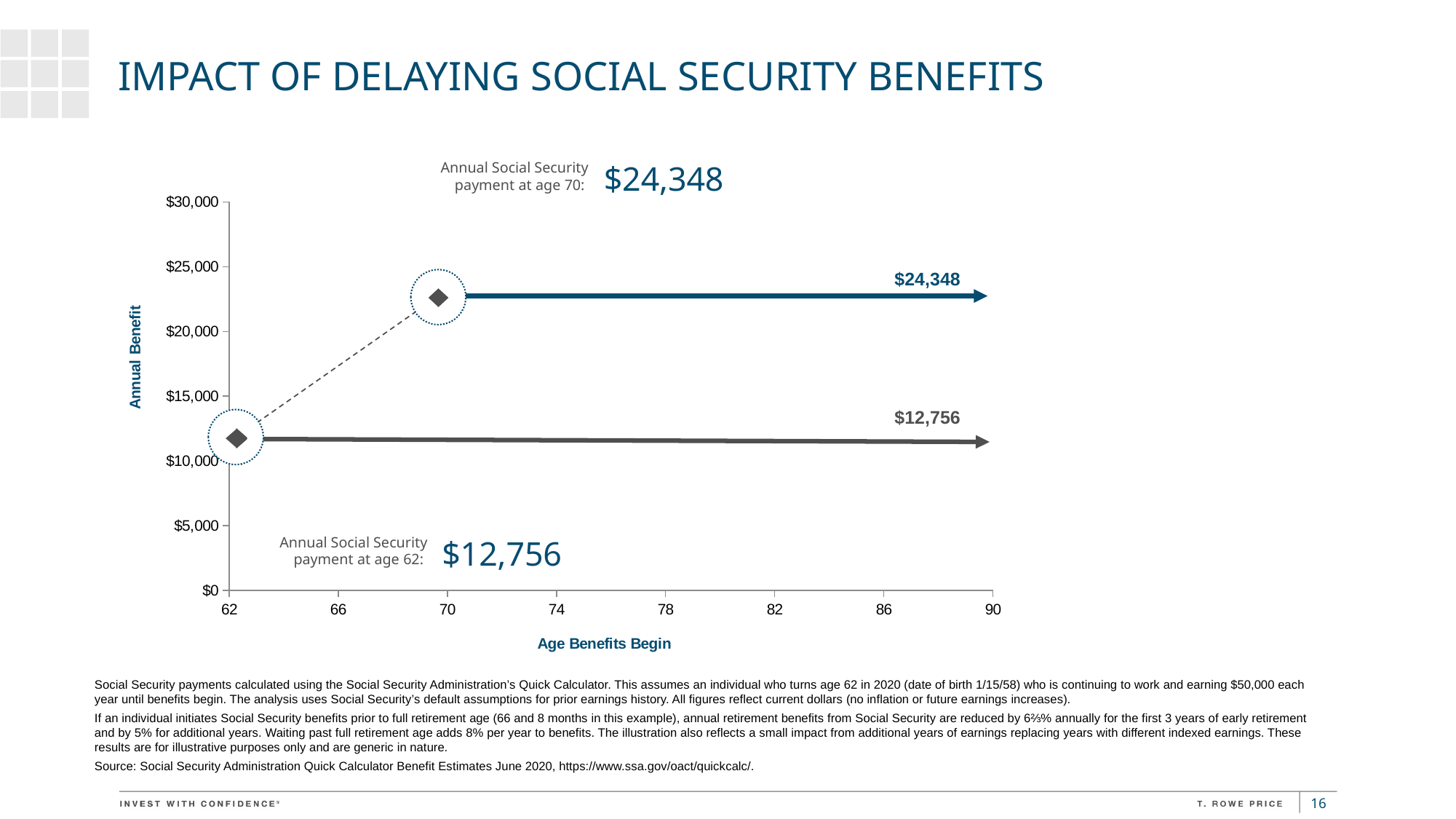
What is the title of the y axis? Annual Benefit Which starting age gives the higher annual benefit, 62 or 70? 70 What is the title of the x axis? Age Benefits Begin How much larger is the annual benefit when starting at age 70 than when starting at age 62? $11,592 Is the annual benefit for starting at age 62 greater or less than $15,000? less What is the annual Social Security payment if benefits begin at age 70? $24,348 Which of the two starting ages shown yields the lowest annual benefit? 62 What is the annual Social Security payment if benefits begin at age 62? $12,756 How many benefit-start scenarios (lines) are plotted on the chart? 2 Does the annual benefit for each scenario rise, fall, or stay flat as age increases along the x axis? stays flat What kind of chart is shown on the slide? line chart Is the annual benefit for starting at age 70 greater or less than $20,000? greater